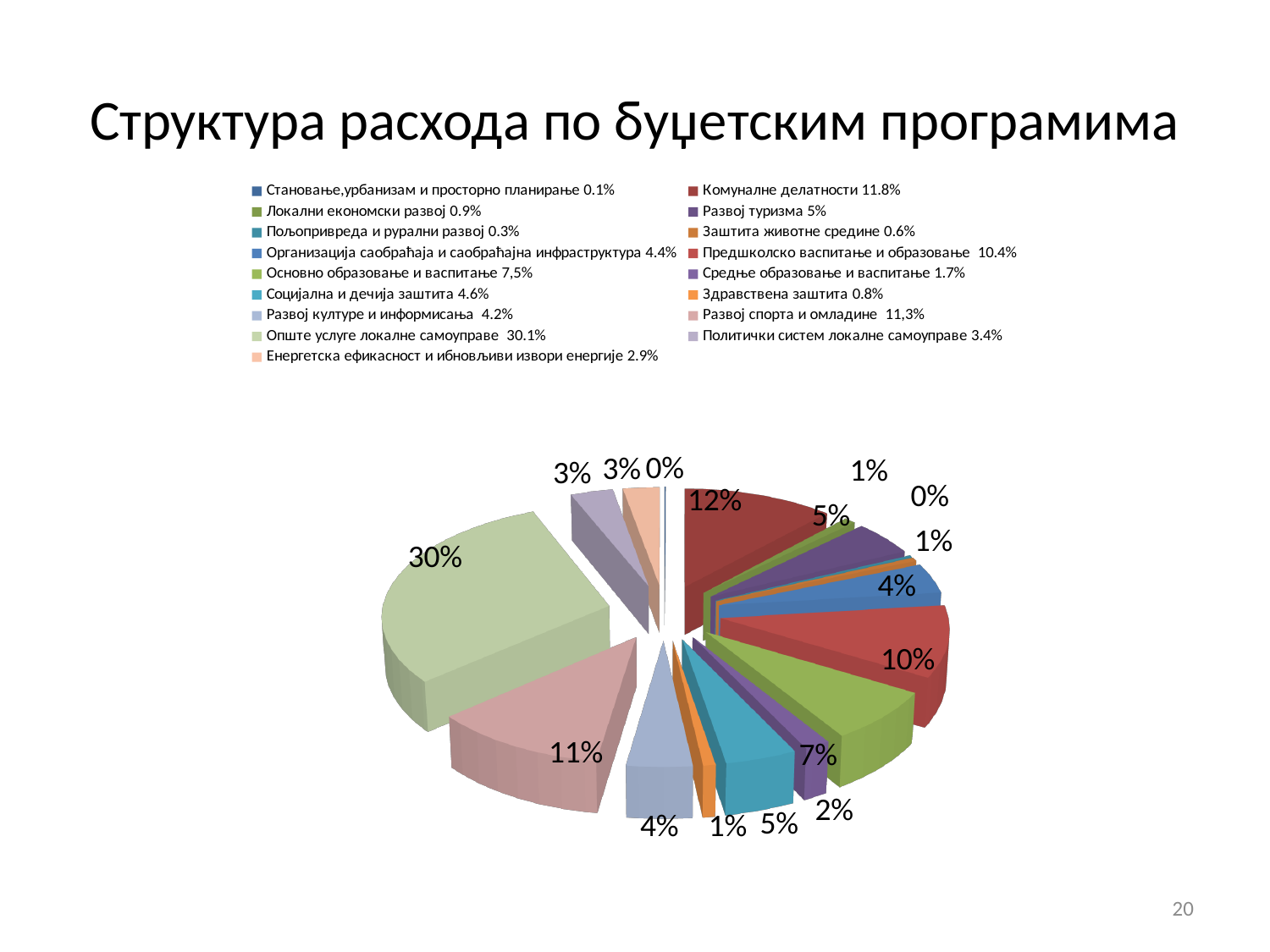
Which category has the largest share of the pie? Опште услуге локалне самоуправе What is the title of the chart on the slide? Структура расхода по буџетским програмима What type of chart is shown on the slide? pie chart What share does the legend give for Опште услуге локалне самоуправе? 30.1% How many categories does the legend of the pie chart list? 17 What is the difference in percentage points between the legend shares of Опште услуге локалне самоуправе and Комуналне делатности? 18.3 What share does the legend give for Развој туризма? 5% What share does the legend give for Комуналне делатности? 11.8% Which category has the smallest share according to the legend? Становање,урбанизам и просторно планирање What share does the legend give for Предшколско васпитање и образовање? 10.4% Which has a larger share: Комуналне делатности or Предшколско васпитање и образовање? Комуналне делатности What data label is shown on the largest slice of the pie? 30%